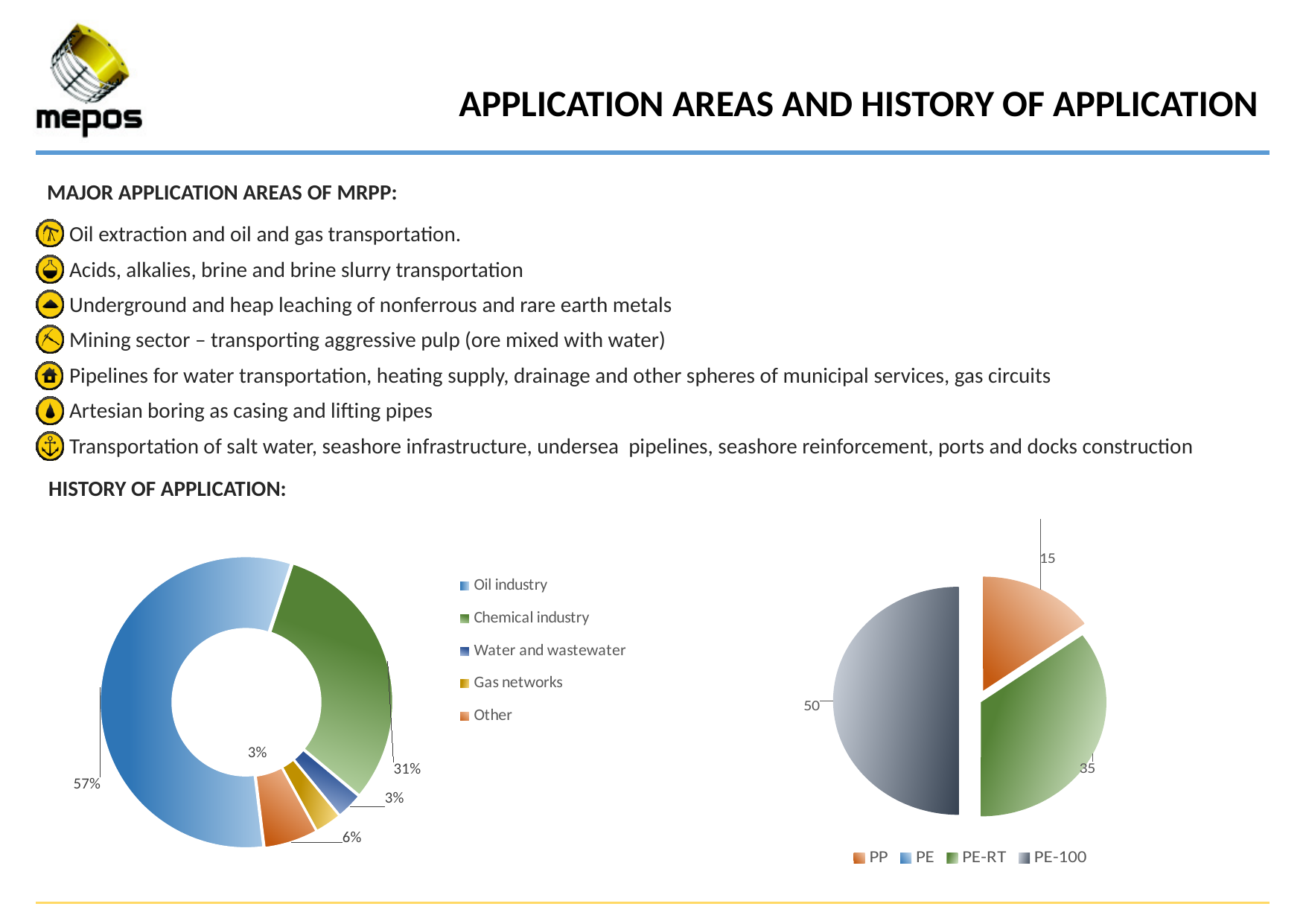
In the left doughnut chart, what share is shown for Oil industry? 57% In the left doughnut chart, what share is shown for Gas networks? 3% How many entries does the legend of the right pie chart list? 4 In the right pie chart, what value is shown for PE-RT? 35 In the left doughnut chart, which category has the largest share? Oil industry In the right pie chart, which is larger, PE-RT or PP? PE-RT How many categories does the legend of the left doughnut chart list? 5 In the right pie chart, what value is shown for PE-100? 50 In the left doughnut chart, what is the difference between the Oil industry and Chemical industry shares? 26% In the left doughnut chart, what share is shown for Other? 6% In the right pie chart, what value is shown for PP? 15 In the left doughnut chart, what share is shown for Chemical industry? 31%